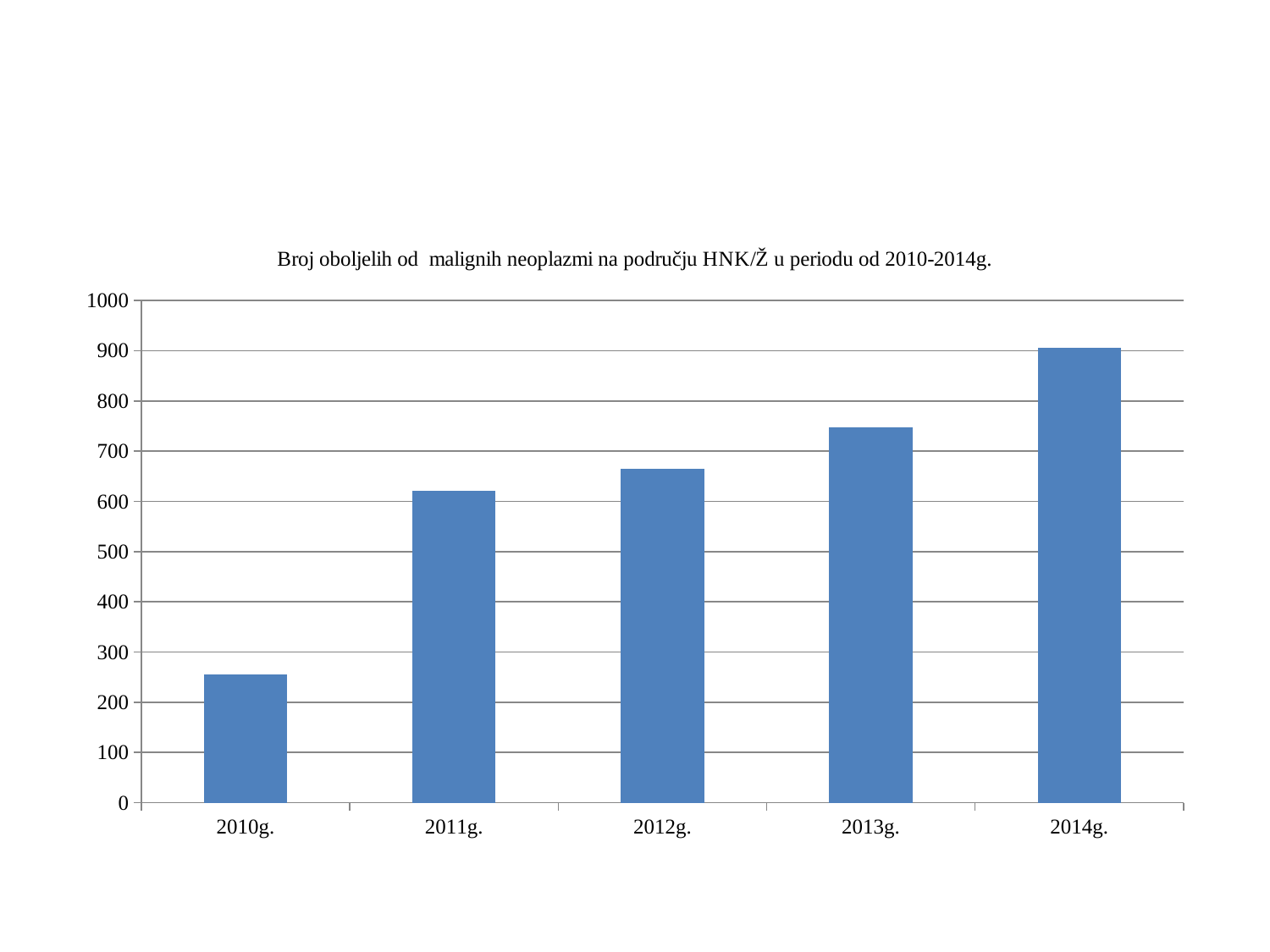
Which year has the highest number of cases? 2014g. Is the value for 2012g. greater or less than 700? less Is the value for 2010g. greater or less than 300? less What kind of chart is shown on the slide? bar chart What is the title of the chart? Broj oboljelih od malignih neoplazmi na području HNK/Ž u periodu od 2010-2014g. Is the value for 2014g. greater or less than 800? greater How many years are plotted on the x axis? 5 Do the values rise or fall from 2010g. to 2014g.? rise Which is larger, the value for 2011g. or the value for 2013g.? 2013g. Which year has the lowest number of cases? 2010g.